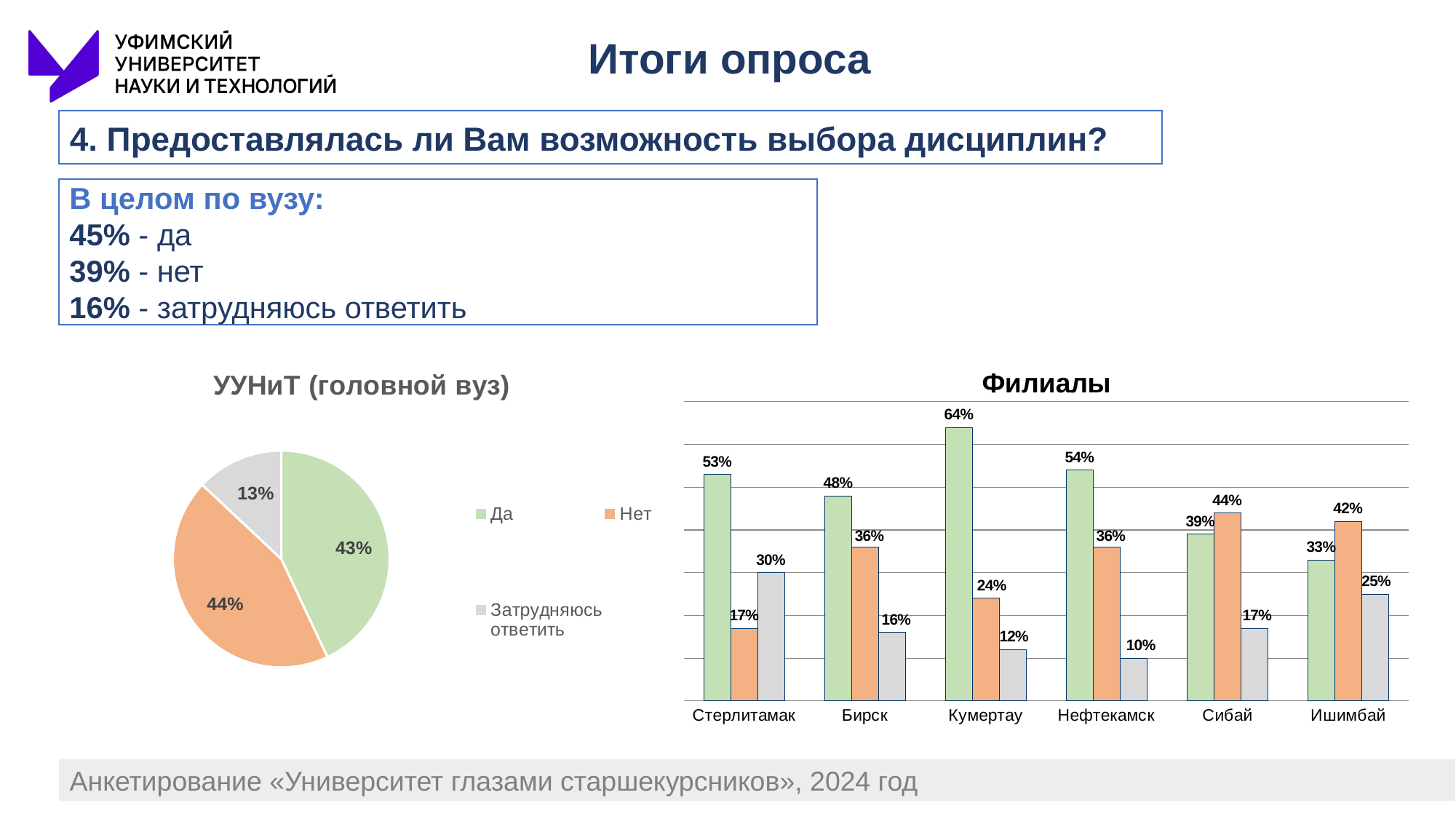
In the pie chart 'УУНиТ (головной вуз)', how many entries does the legend list? 3 In the 'Филиалы' chart, which is larger for Ишимбай: the green (Да) bar or the orange (Нет) bar? orange (Нет), 42% In the 'Филиалы' chart, what is the difference between the orange (Нет) bar for Сибай and the orange bar for Стерлитамак? 27% In the 'Филиалы' chart, how many branch categories are shown on the x axis? 6 In the 'Филиалы' chart, what is the value of the grey (Затрудняюсь ответить) bar for Стерлитамак? 30% In the 'Филиалы' chart, what is the value of the green (Да) bar for Кумертау? 64% In the pie chart 'УУНиТ (головной вуз)', what share is labelled 'Нет'? 44% In the 'Филиалы' chart, which branch has the highest green (Да) bar? Кумертау In the 'Филиалы' chart, which branch has the lowest grey (Затрудняюсь ответить) bar? Нефтекамск In the pie chart 'УУНиТ (головной вуз)', what share is labelled 'Затрудняюсь ответить'? 13% In the 'Филиалы' chart, what is the value of the orange (Нет) bar for Бирск? 36% What kind of chart is the 'Филиалы' chart? bar chart